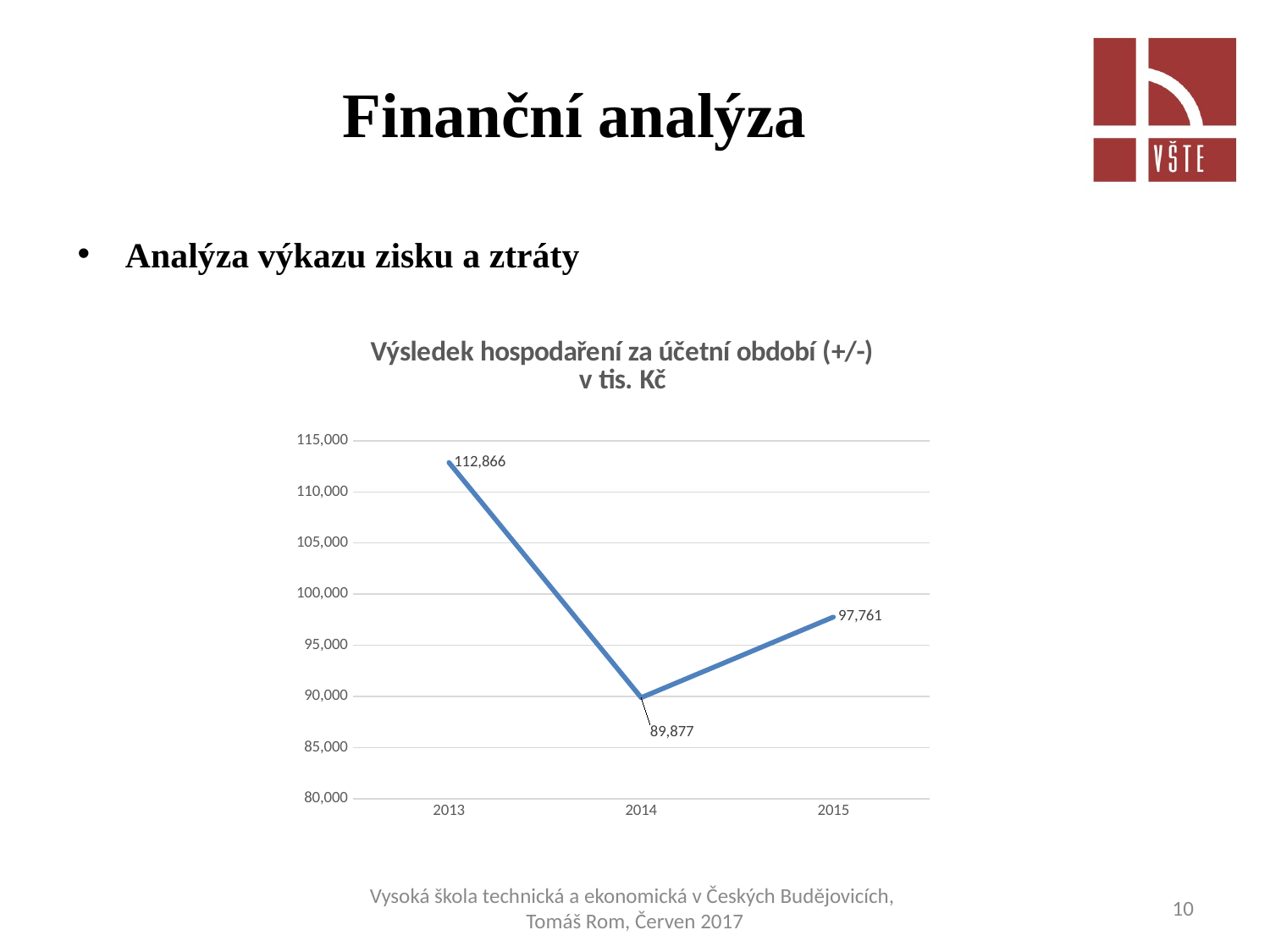
What is the difference between the values for 2013 and 2014? 22,989 How many years are plotted on the chart? 3 Is the value for 2015 greater or less than 100,000? less What is the value for 2014? 89,877 What is the value for 2013? 112,866 Which year has the lowest value? 2014 Which is larger, the value for 2013 or the value for 2015? 2013 What is the difference between the values for 2015 and 2014? 7,884 What is the value for 2015? 97,761 What is the title of the chart? Výsledek hospodaření za účetní období (+/-) v tis. Kč Which year has the highest value? 2013 What kind of chart is shown? line chart